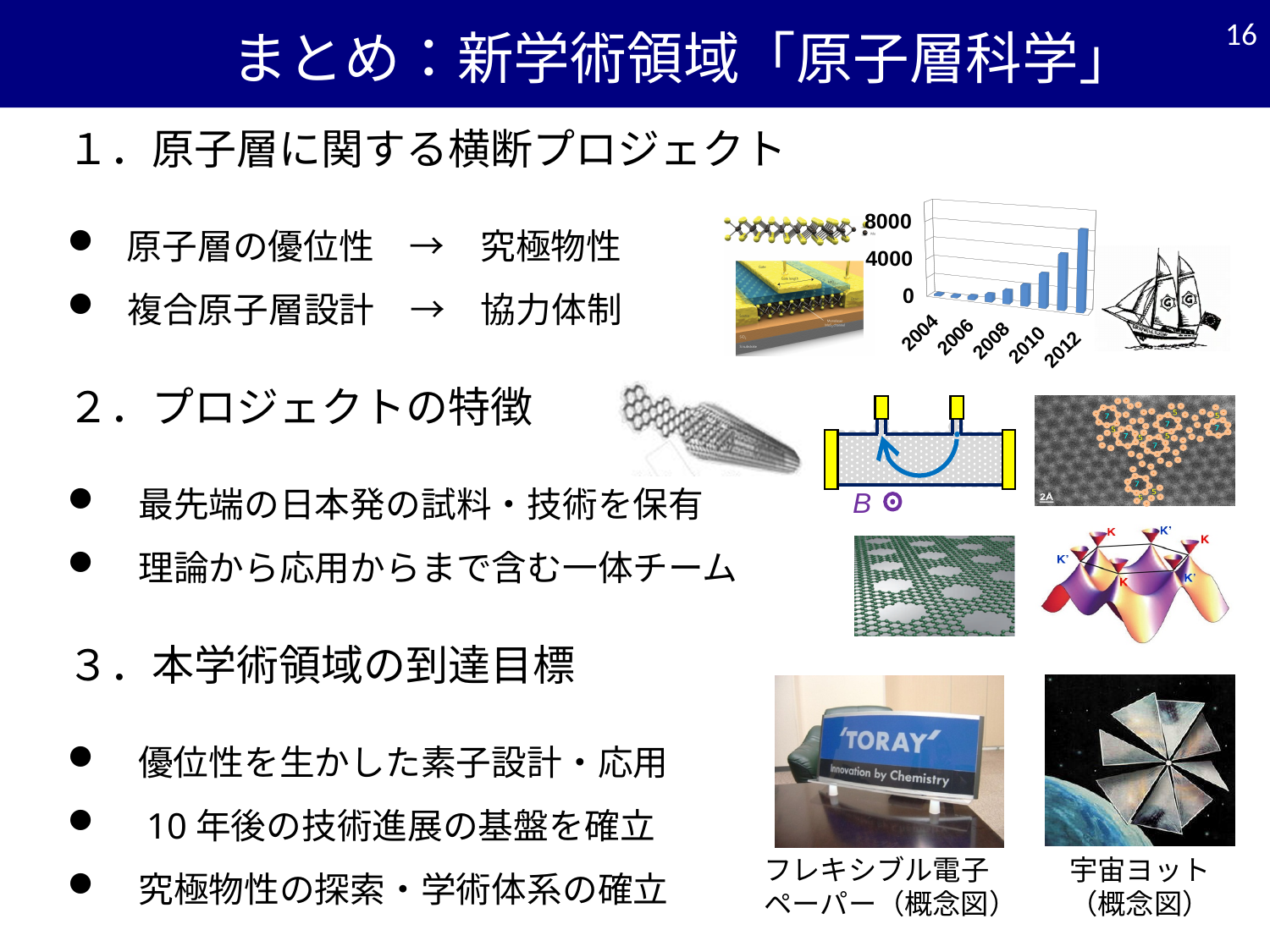
In the bar chart with years on the x axis, which is larger, the value for 2008 or the value for 2010? 2010 In the bar chart with years on the x axis, is the value for 2012 greater or less than 4000? greater In the bar chart with years on the x axis, which is larger, the value for 2010 or the value for 2012? 2012 What kind of chart is shown on the slide next to the years 2004 to 2012? bar chart In the bar chart with years on the x axis, do the values rise or fall from 2004 to 2012? rise What is the highest tick value shown on the y axis of the bar chart with years on the x axis? 8000 In the bar chart with years on the x axis, which year has the highest bar? 2012 What is the first year labelled on the x axis of the bar chart? 2004 In the bar chart with years on the x axis, is the value for 2008 greater or less than 4000? less In the bar chart with years on the x axis, is the value for 2006 greater or less than 4000? less In the bar chart with years on the x axis, which is larger, the value for 2006 or the value for 2012? 2012